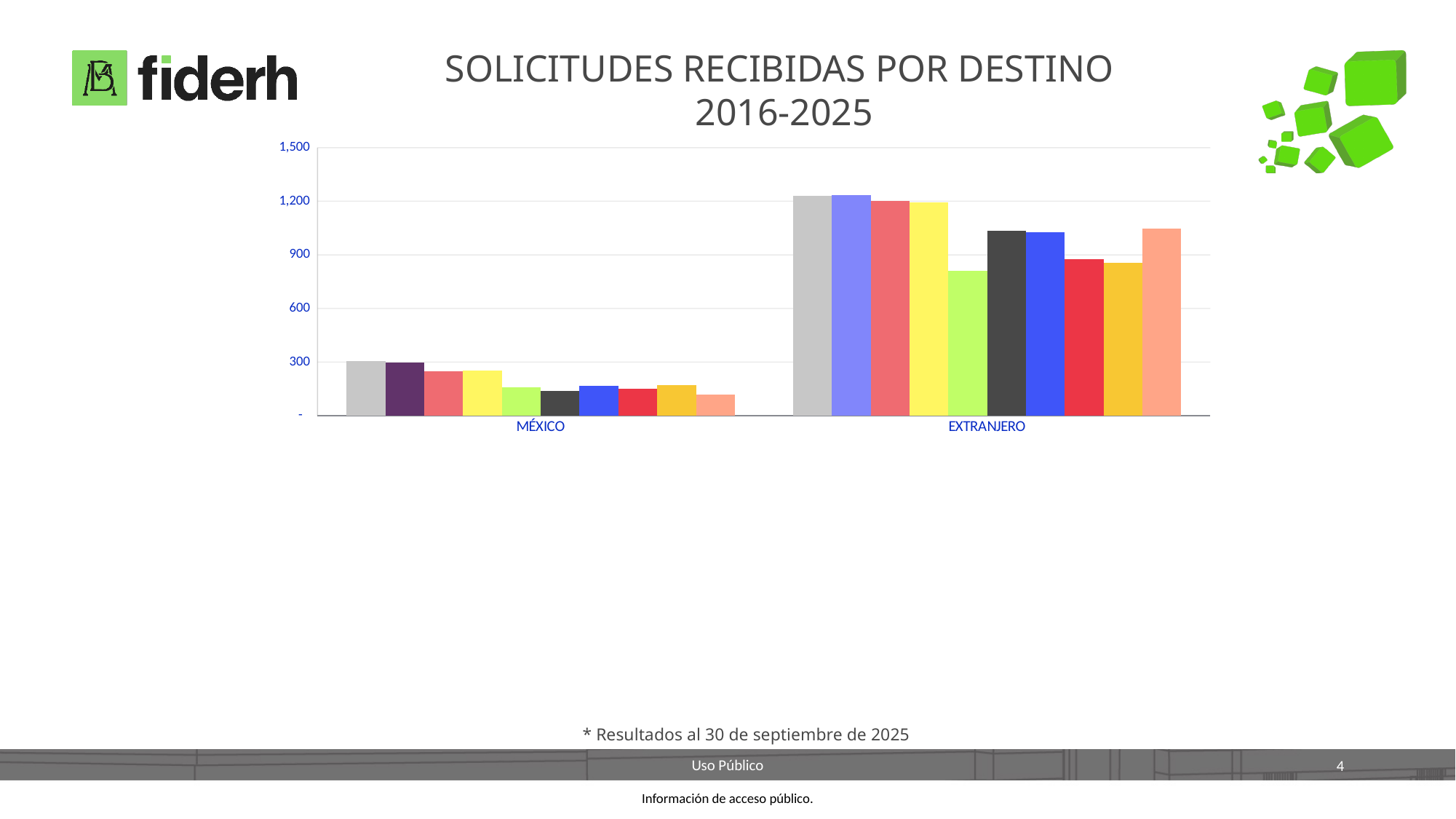
Is the value of the tallest bar in the MÉXICO category greater or less than 600? less What kind of chart is shown on the slide? Bar chart Which category, MÉXICO or EXTRANJERO, has the taller bars? EXTRANJERO What is the title of the chart on the slide? SOLICITUDES RECIBIDAS POR DESTINO 2016-2025 How many destination categories are shown on the x axis of the chart? 2 What is the highest value shown on the vertical axis of the chart? 1,500 Is the value of the shortest bar in the EXTRANJERO category greater or less than 900? less Is the value of the shortest bar in the MÉXICO category greater or less than 300? less How many bars are plotted for the MÉXICO category? 10 How many bars are plotted for the EXTRANJERO category? 10